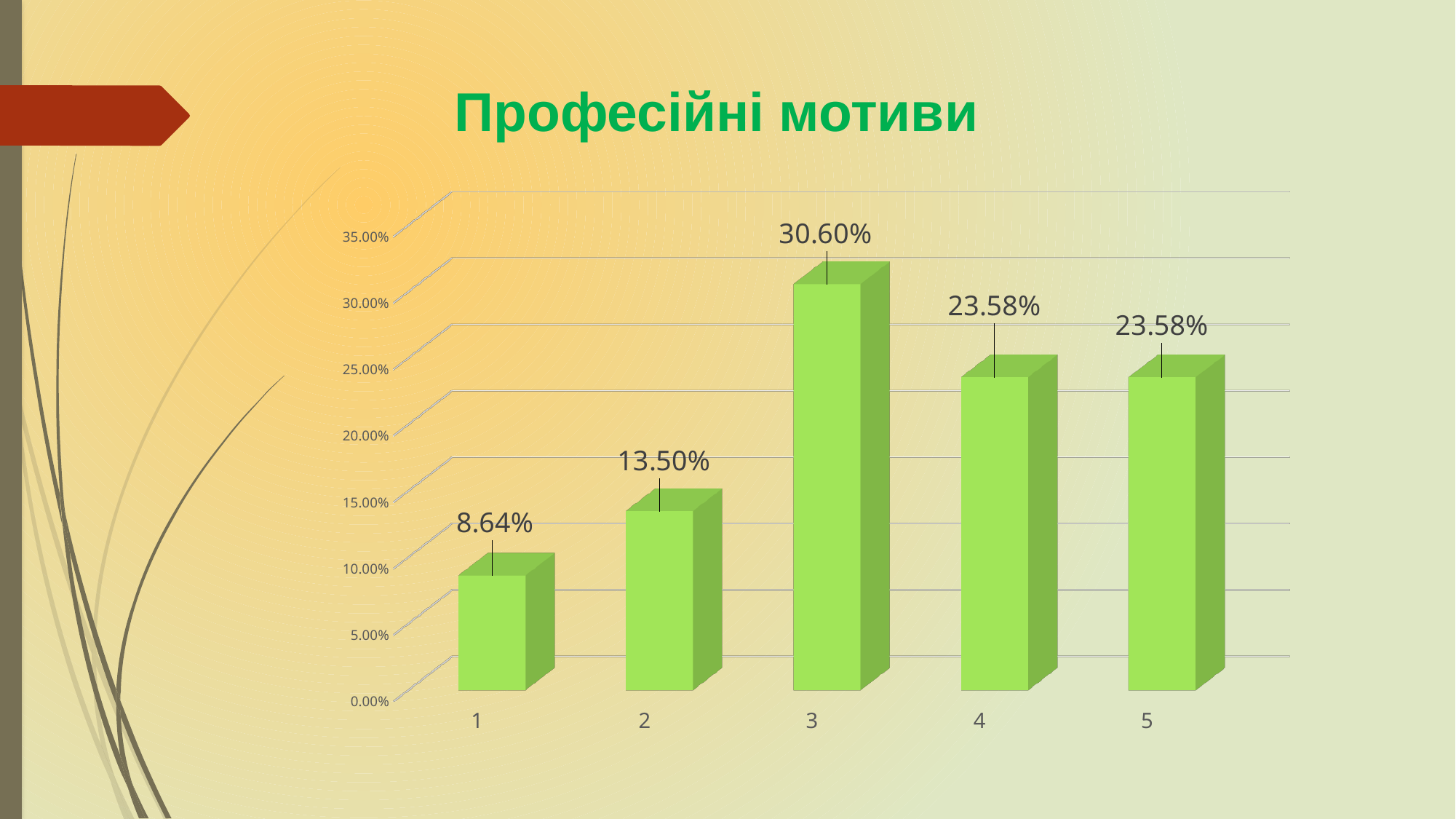
What is the value for category 4? 23.58% What kind of chart is shown on the slide? bar chart What is the difference between the values for category 2 and category 1? 4.86% What is the value for category 3? 30.60% Which category has the highest value? 3 What is the value for category 2? 13.50% How many categories are shown on the x axis? 5 What is the value for category 1? 8.64% Which is larger, the value for category 2 or the value for category 4? category 4 Which category has the lowest value? 1 What is the title of the chart? Професійні мотиви What is the difference between the values for category 3 and category 1? 21.96%